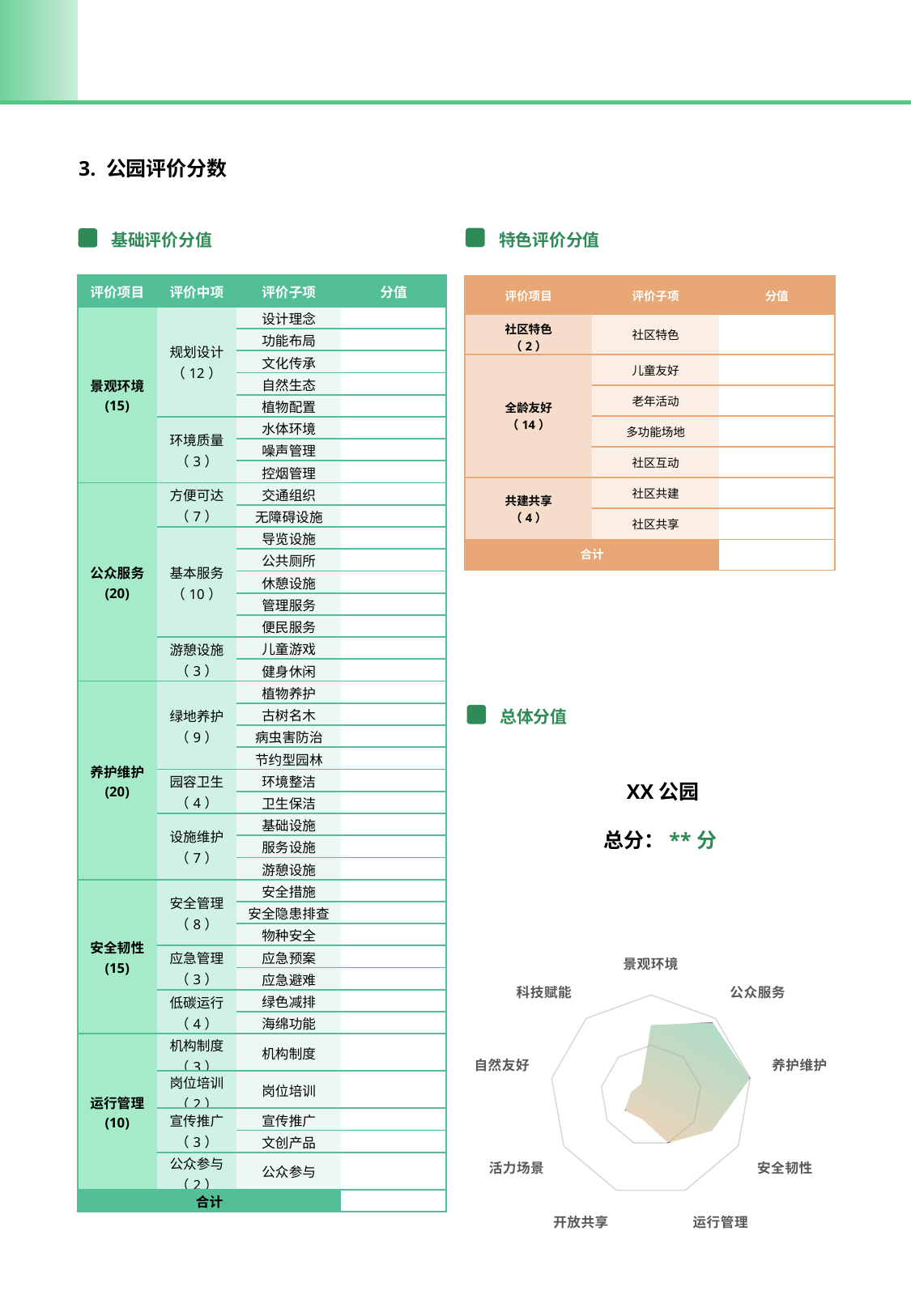
Which category label sits at the top of the radar chart? 景观环境 How many categories (axes) does the radar chart have? 9 In the radar chart, which is larger, the value for 公众服务 or the value for 自然友好? 公众服务 What name is written above the radar chart? XX 公园 What kind of chart is shown under the 总体分值 heading? radar chart In the radar chart, which is larger, the value for 安全韧性 or the value for 开放共享? 安全韧性 In the radar chart, which is larger, the value for 养护维护 or the value for 活力场景? 养护维护